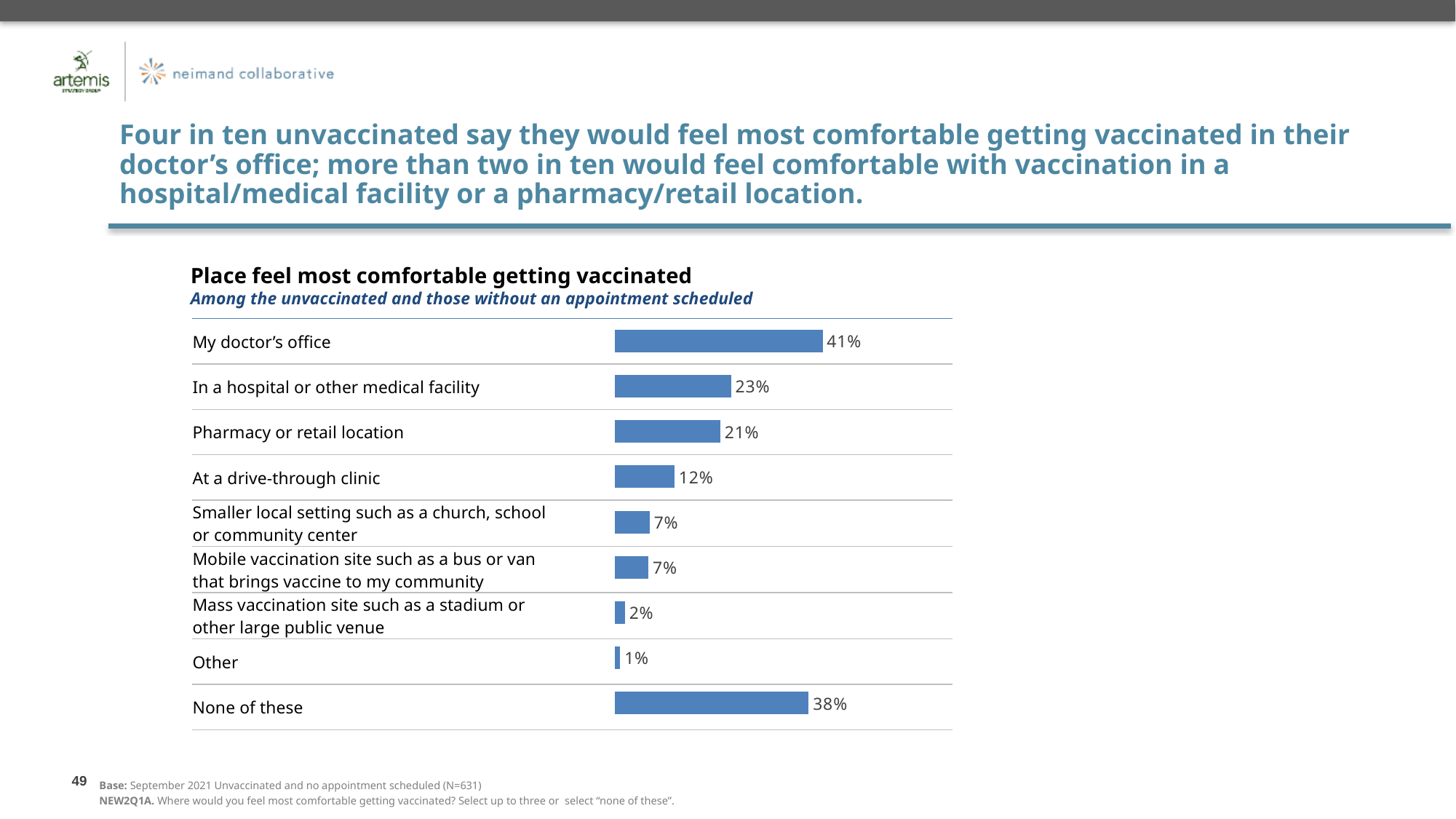
What is the value for 'Mobile vaccination site such as a bus or van that brings vaccine to my community'? 7% What kind of chart is shown on the slide? Bar chart Which is larger: the value for 'At a drive-through clinic' or the value for 'Mass vaccination site such as a stadium or other large public venue'? At a drive-through clinic What is the difference in percentage points between 'My doctor's office' and 'In a hospital or other medical facility'? 18 Which place has the highest percentage in the chart? My doctor's office What is the difference in percentage points between 'None of these' and 'Pharmacy or retail location'? 17 What percentage of respondents said they would feel most comfortable getting vaccinated at their doctor's office? 41% How many categories are shown in the chart? 9 What percentage selected 'None of these'? 38% Which category has the lowest percentage in the chart? Other What is the title of the chart? Place feel most comfortable getting vaccinated What is the value for 'Pharmacy or retail location'? 21%